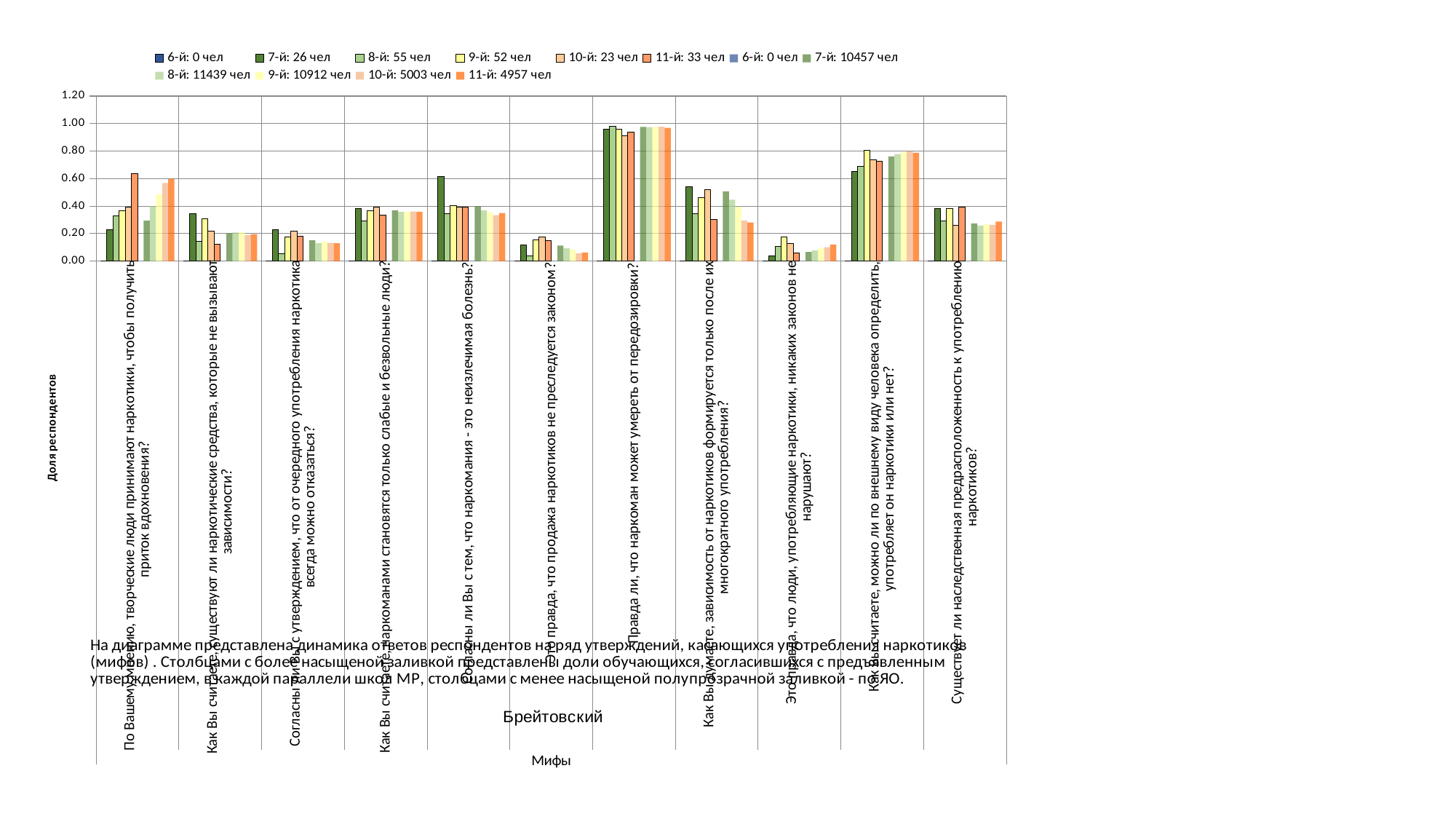
Is the value for '7-й: 26 чел' in the category 'Согласны ли Вы с тем, что наркомания - это неизлечимая болезнь?' greater or less than 0.40? greater Is the value for '7-й: 26 чел' in the category 'Правда ли, что наркоман может умереть от передозировки?' greater or less than 0.80? greater For the series '7-й: 26 чел', which is larger: the value for 'Правда ли, что наркоман может умереть от передозировки?' or the value for 'Это правда, что люди, употребляющие наркотики, никаких законов не нарушают?' Правда ли, что наркоман может умереть от передозировки? What kind of chart is shown on the slide? bar chart What is the title of the x axis of the chart? Мифы Which category has the highest bars in the chart? Правда ли, что наркоман может умереть от передозировки? How many series does the chart legend list? 12 Is the value for '7-й: 26 чел' in the category 'Это правда, что люди, употребляющие наркотики, никаких законов не нарушают?' greater or less than 0.20? less What is the title of the y axis of the chart? Доля респондентов How many categories (myths) are shown along the x axis of the chart? 11